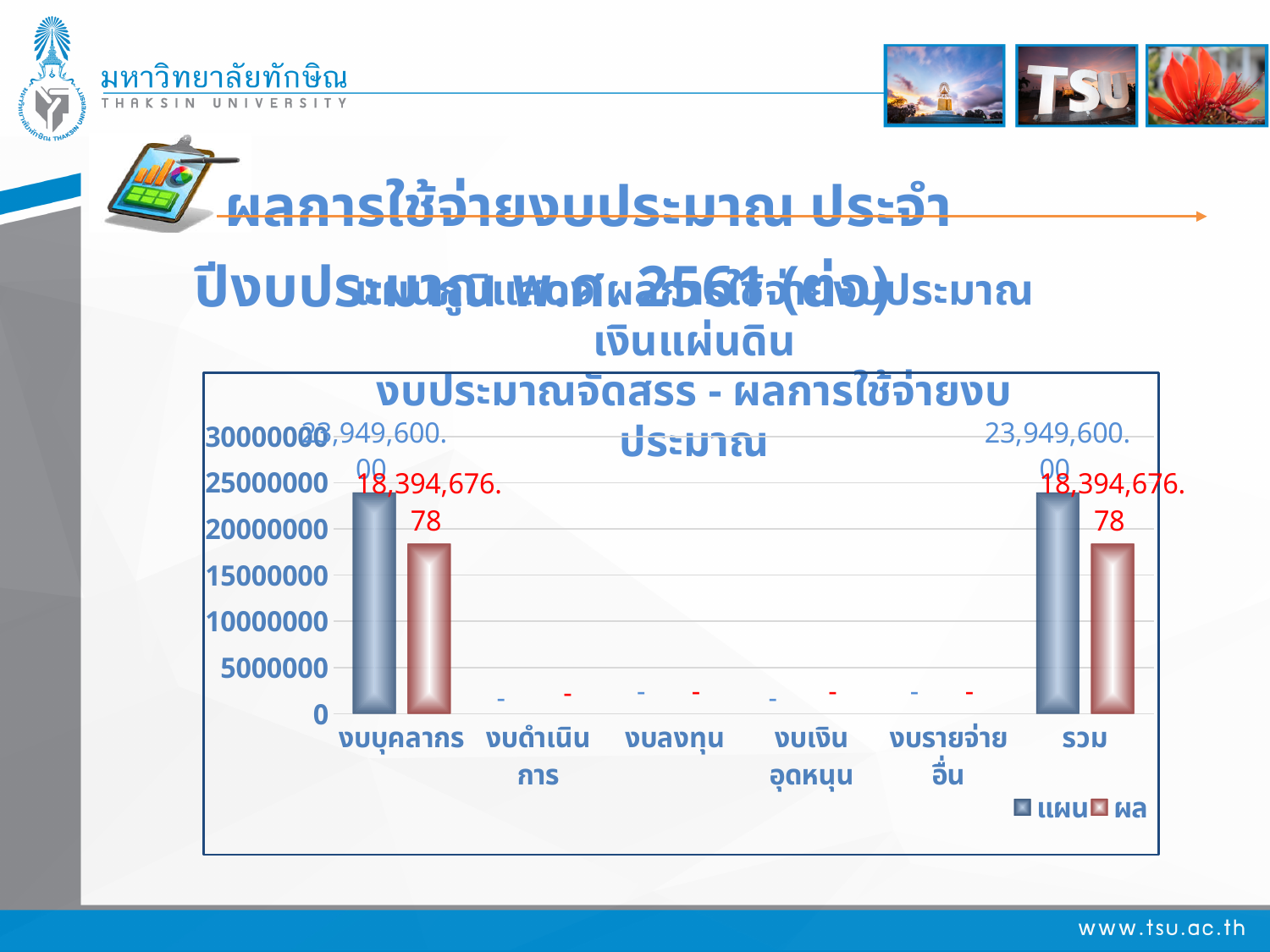
How many categories are shown on the x axis? 6 What are the two series names in the legend? แผน and ผล What type of chart is shown on the slide? bar chart What is the value of ผล for งบบุคลากร? 18,394,676.78 What is the value of แผน for งบบุคลากร? 23,949,600.00 How many series does the legend list? 2 What is the title of the chart? งบประมาณจัดสรร - ผลการใช้จ่ายงบประมาณ What is the value of ผล for รวม? 18,394,676.78 Which is larger for งบบุคลากร, แผน or ผล? แผน Is the value of ผล for งบบุคลากร greater or less than 20000000? less What is the difference between แผน and ผล for รวม? 5,554,923.22 What is the value of แผน for รวม? 23,949,600.00